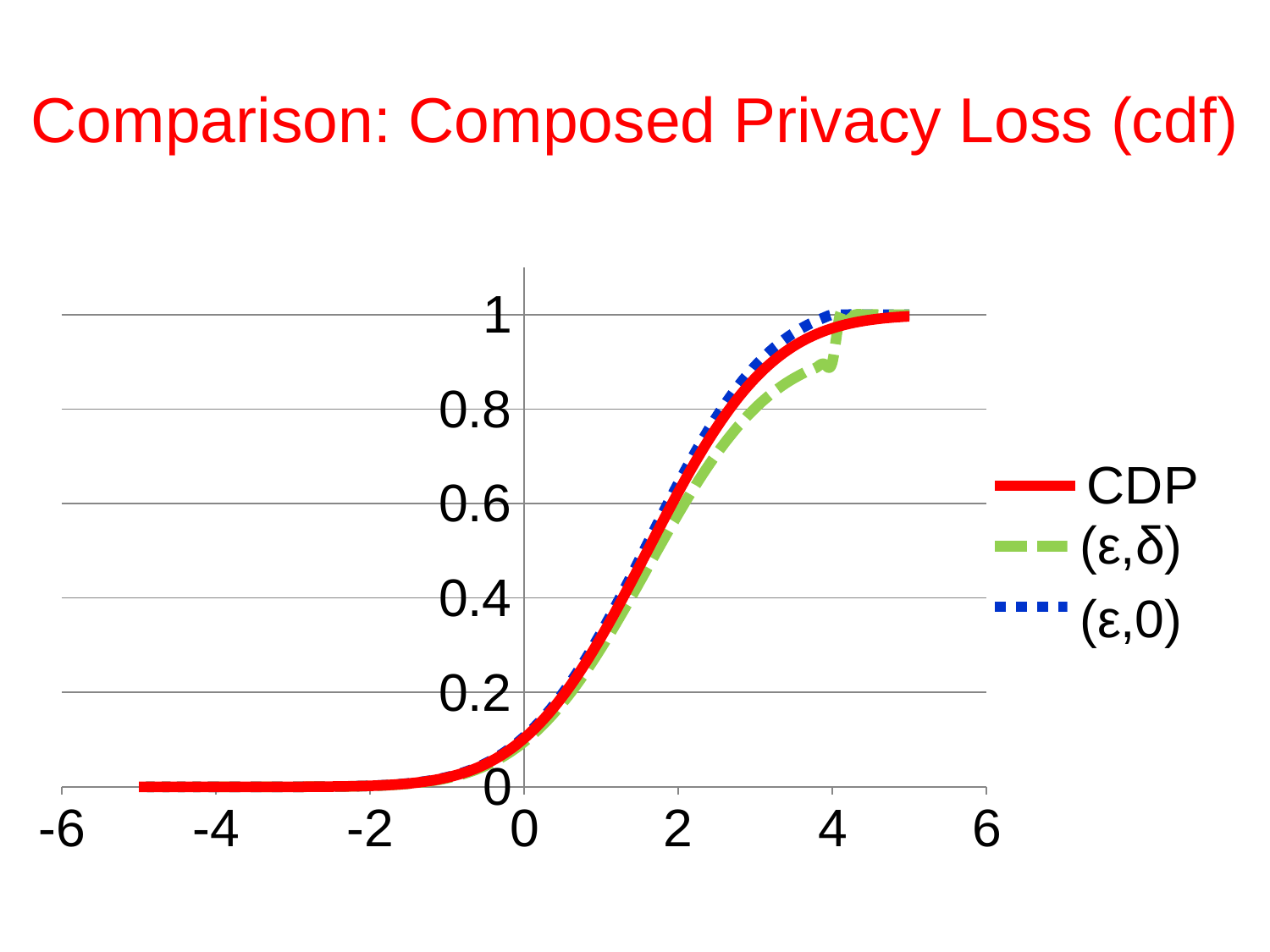
Do the values of the CDP series rise or fall as x increases from -6 to 6? rise Is the value of the (ε,δ) series at x = 3 greater or less than 0.6? greater What is the title of the chart? Comparison: Composed Privacy Loss (cdf) How many series does the legend list? 3 Is the value of the CDP series at x = 0 greater or less than 0.2? less Is the value of the (ε,0) series at x = -2 greater or less than 0.2? less Which series is drawn as a solid red line? CDP At x = 4, which series has the larger value, (ε,δ) or (ε,0)? (ε,0) What kind of chart is shown on the slide? line chart